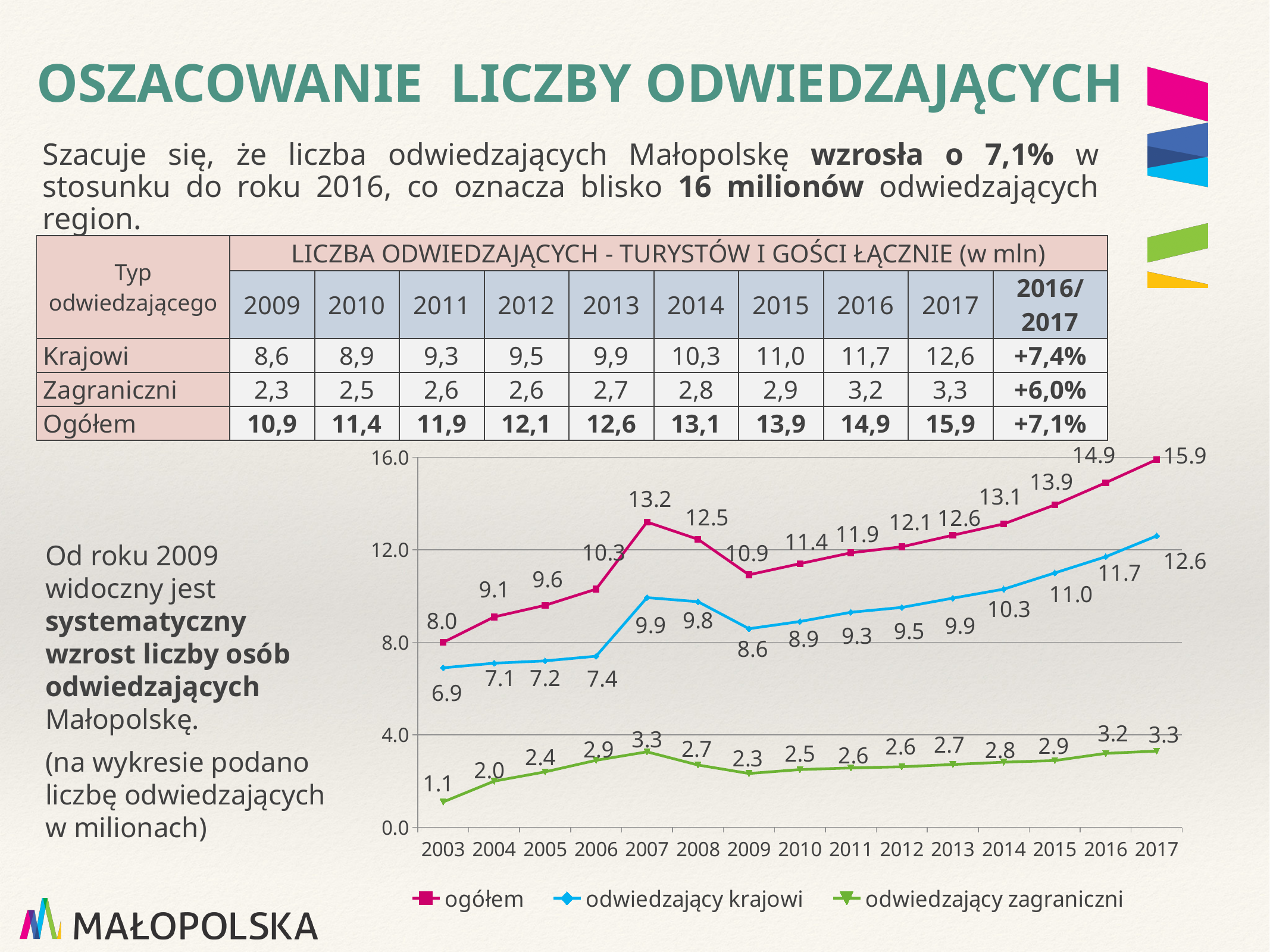
Which is larger: the ogółem value in 2007 or in 2008? 2007 How many series does the chart legend list? 3 What kind of chart is shown on the slide? line chart How many years are shown on the x axis of the chart? 15 Does the ogółem series rise or fall from 2009 to 2017? rise What is the value of the odwiedzający zagraniczni series in 2003? 1.1 In which year does the ogółem series reach its highest value? 2017 What is the value of the odwiedzający krajowi series in 2007? 9.9 What is the difference between the ogółem values for 2017 and 2016? 1.0 Is the value of the odwiedzający krajowi series in 2017 greater or less than 12.0? greater In which year does the odwiedzający zagraniczni series have its lowest value? 2003 What is the value of the ogółem series in 2017? 15.9